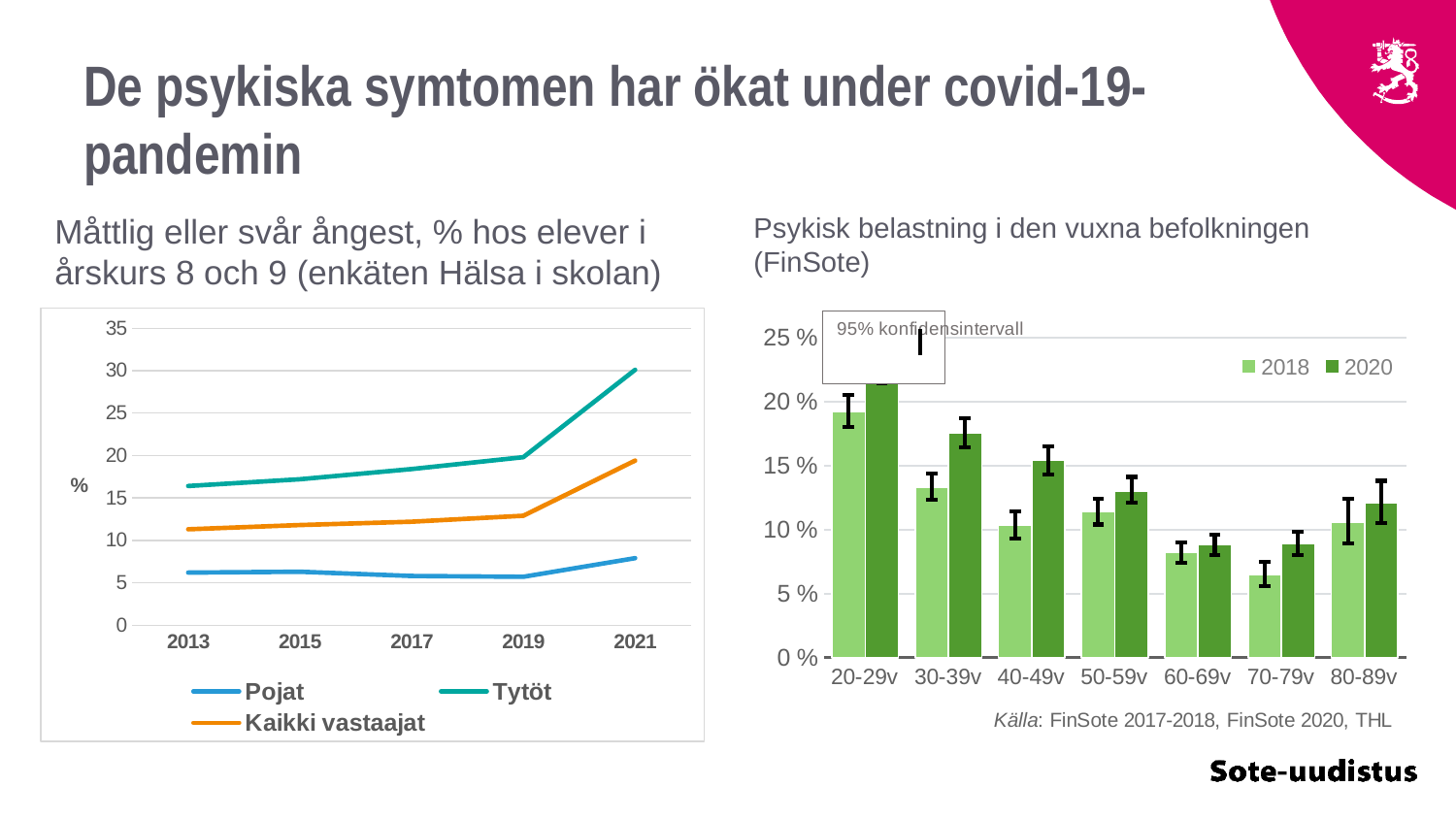
In the left chart (Måttlig eller svår ångest), do the values for Tytöt rise or fall from 2013 to 2021? rise In the left chart (Måttlig eller svår ångest), is the value for Tytöt in 2021 greater or less than 25? greater In the right chart (Psykisk belastning i den vuxna befolkningen), is the 2020 value for 20-29v greater or less than 20 %? greater In the left chart (Måttlig eller svår ångest), is the value for Pojat in 2021 greater or less than 10? less In the right chart (Psykisk belastning i den vuxna befolkningen), which age group has the highest 2020 value? 20-29v What kind of chart is the right chart (Psykisk belastning i den vuxna befolkningen)? bar chart What kind of chart is the left chart (Måttlig eller svår ångest)? line chart How many series does the legend of the left chart (Måttlig eller svår ångest) list? 3 How many age groups are shown on the x axis of the right chart (Psykisk belastning i den vuxna befolkningen)? 7 In the left chart (Måttlig eller svår ångest), which series has the lowest values across all years? Pojat How many years are plotted on the x axis of the left chart (Måttlig eller svår ångest)? 5 In the left chart (Måttlig eller svår ångest), which series has the highest values across all years? Tytöt